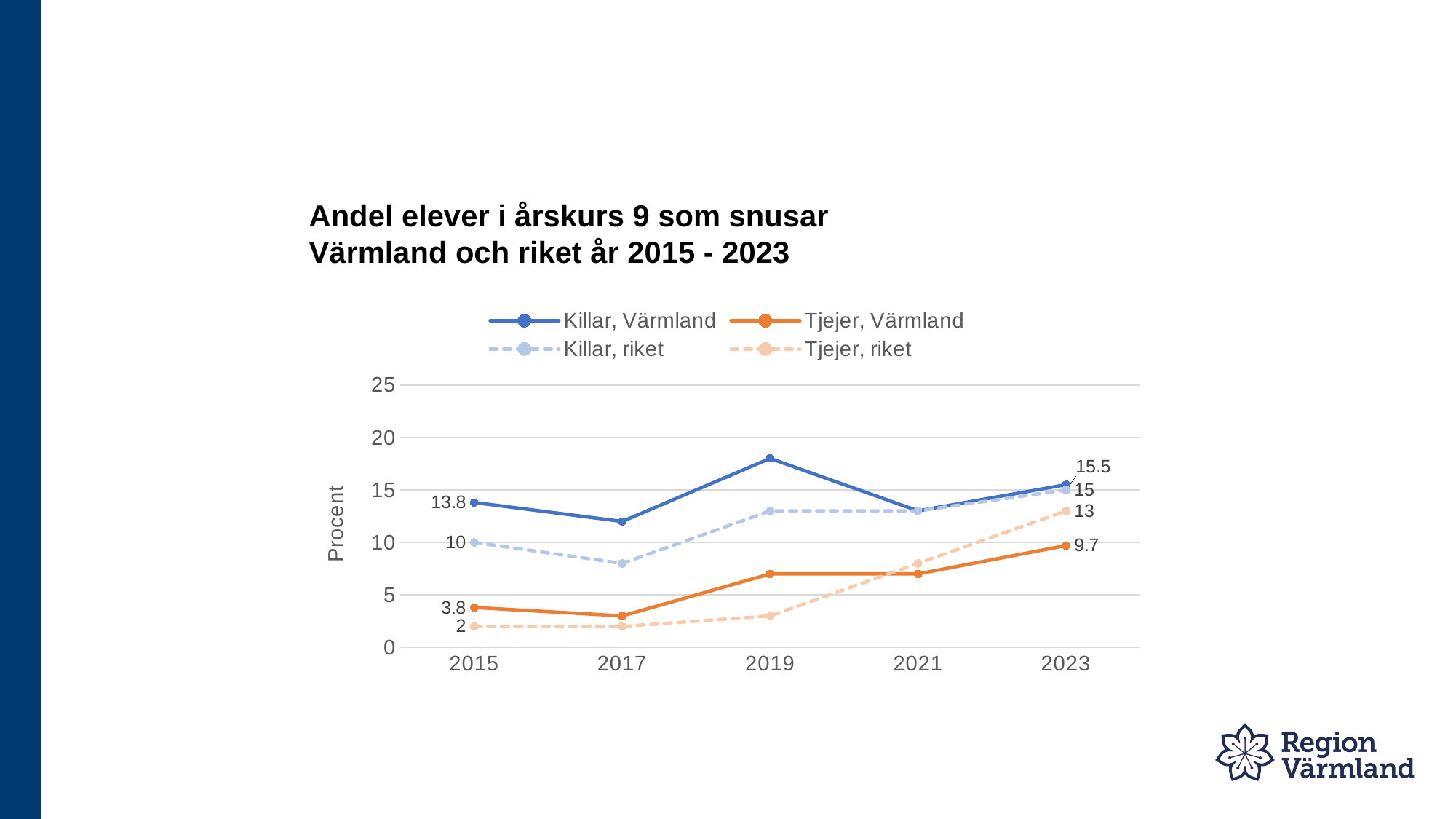
How many years are shown on the x axis? 5 What is the value for Killar, Värmland in 2015? 13.8 What is the value for Killar, riket in 2023? 15 Which series has the lowest value in 2015? Tjejer, riket How many series does the legend list? 4 What is the value for Tjejer, riket in 2015? 2 Does the Tjejer, riket series rise or fall from 2015 to 2023? rise What type of chart is shown on the slide? line chart What is the difference between Tjejer, riket in 2023 and Tjejer, riket in 2015? 11 Is the value for Killar, Värmland in 2019 greater or less than 15? greater What is the difference between Killar, Värmland and Tjejer, Värmland in 2015? 10 What is the value for Tjejer, Värmland in 2023? 9.7